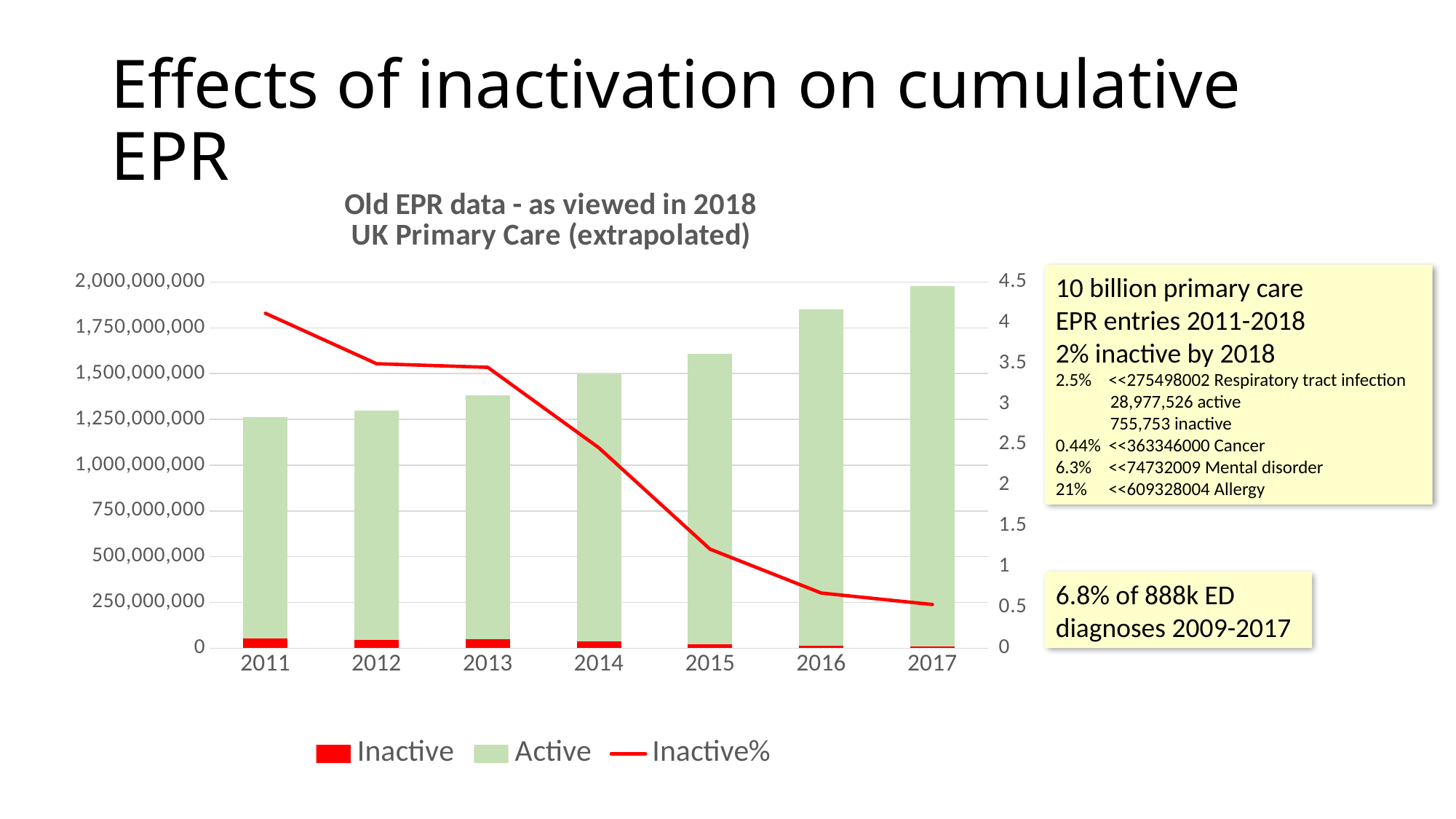
Is the Inactive% value for 2015 greater or less than 1.5? less How many years are shown on the x axis of the chart? 7 How many series does the chart legend list? 3 Is the total bar value for 2011 greater or less than 1,500,000,000? less Do the stacked bar totals rise or fall from 2011 to 2017? rise Which year has the shortest stacked bar? 2011 Does the Inactive% line rise or fall from 2011 to 2017? fall Is the total bar value for 2017 greater or less than 1,750,000,000? greater What kind of chart is shown on the slide? bar chart with a line What colour represents the Inactive series in the chart legend? red Which year has the tallest stacked bar? 2017 Which year has the larger stacked bar, 2013 or 2016? 2016